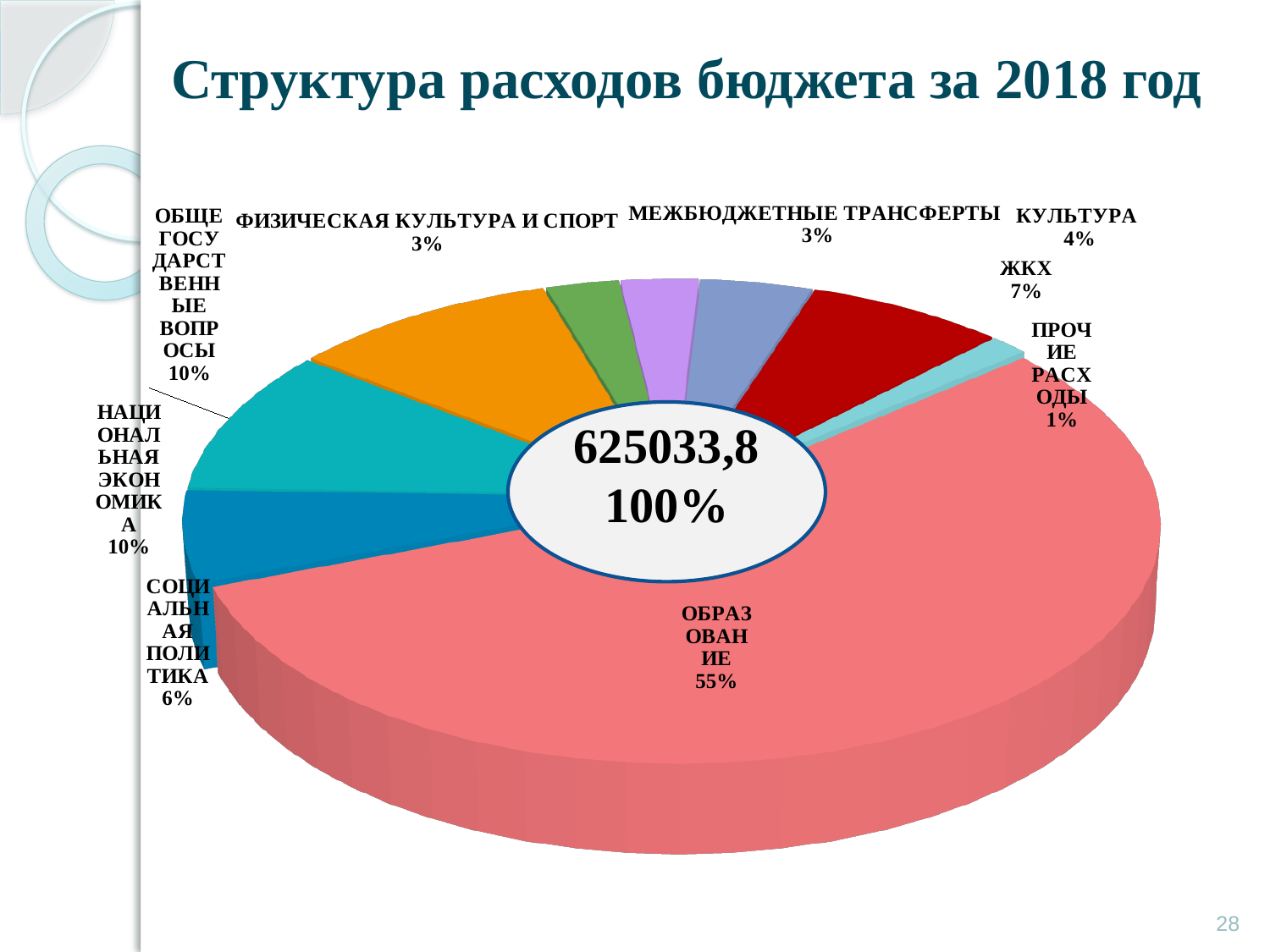
What share of budget expenditure does КУЛЬТУРА account for? 4% What share of budget expenditure does ЖКХ account for? 7% Which category has the smallest share of the pie? ПРОЧИЕ РАСХОДЫ What is the difference in percentage points between ОБРАЗОВАНИЕ and НАЦИОНАЛЬНАЯ ЭКОНОМИКА? 45 Which has a larger share, ЖКХ or СОЦИАЛЬНАЯ ПОЛИТИКА? ЖКХ What is the title of the chart? Структура расходов бюджета за 2018 год What share of budget expenditure does СОЦИАЛЬНАЯ ПОЛИТИКА account for? 6% What total value is printed in the centre of the pie chart? 625033,8 Which category has the largest share of the pie? ОБРАЗОВАНИЕ How many categories are shown in the pie chart? 9 What kind of chart is shown on the slide? pie chart What share of budget expenditure does ОБРАЗОВАНИЕ account for? 55%